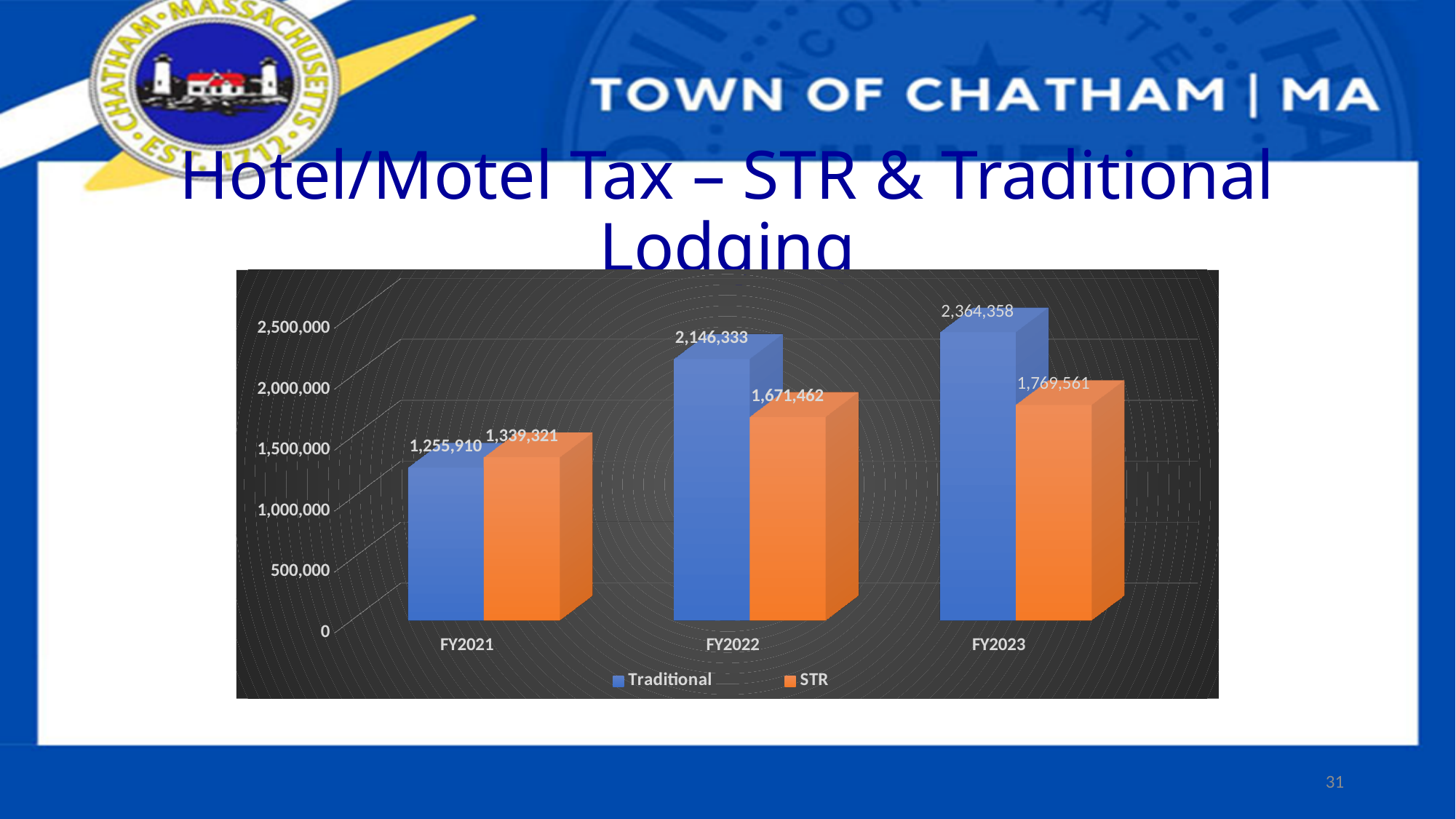
In which fiscal year is the Traditional value highest? FY2023 How many series does the legend list? 2 In FY2021, which is larger, Traditional or STR? STR In which fiscal year is the STR value lowest? FY2021 What is the Traditional value for FY2022? 2,146,333 How much did the Traditional value increase from FY2021 to FY2023? 1,108,448 What is the difference between the Traditional and STR values in FY2023? 594,797 What is the STR value for FY2021? 1,339,321 How many fiscal years are shown on the x axis? 3 In FY2022, which is larger, Traditional or STR? Traditional What is the STR value for FY2023? 1,769,561 What kind of chart is shown on the slide? Bar chart